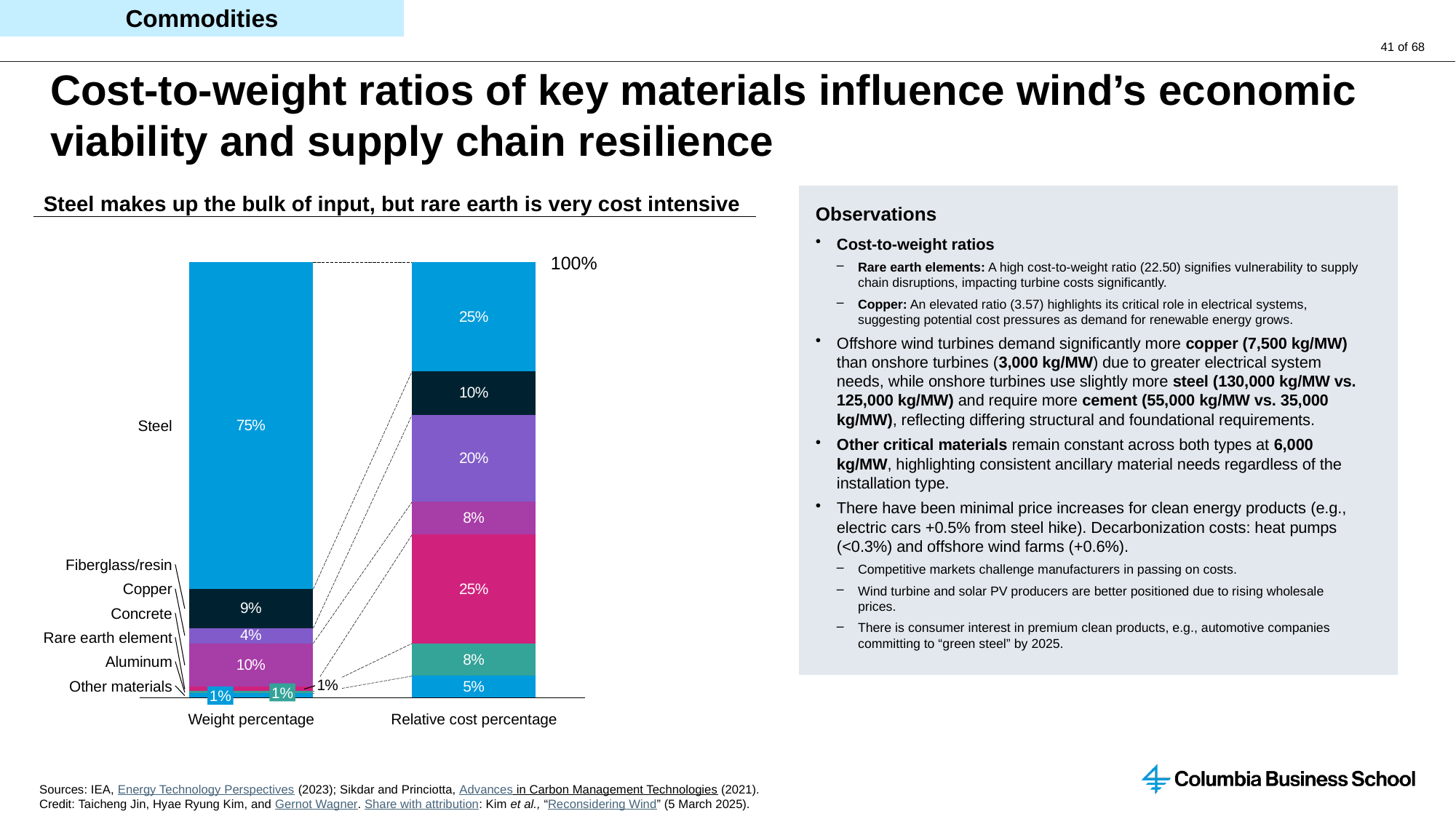
What is the relative cost percentage of Rare earth element? 25% What is the weight percentage of Steel? 75% What is the relative cost percentage of Copper? 20% What type of chart is shown on the slide? Stacked bar chart In the Relative cost percentage bar, which is larger: Copper or Concrete? Copper Which material has the largest share of the Weight percentage bar? Steel How many material categories are shown in the chart? 7 What is the relative cost percentage of Steel? 25% How many percentage points higher is Steel's weight percentage than its relative cost percentage? 50 percentage points What is the weight percentage of Concrete? 10% Which material has the smallest share of the Relative cost percentage bar? Other materials What is the weight percentage of Fiberglass/resin? 9%